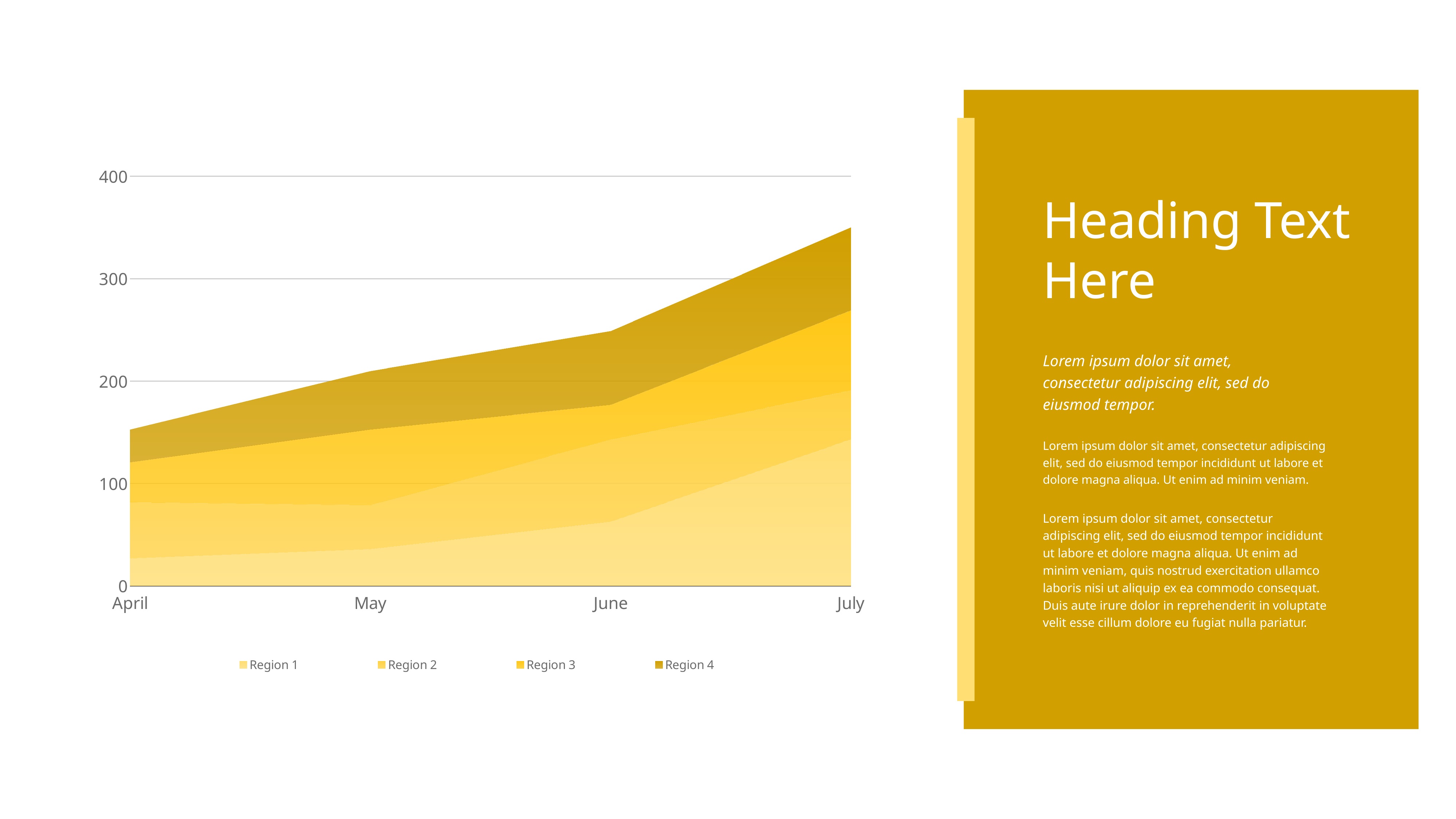
Is the stacked total for June greater or less than 200? greater How many series does the legend list? 4 Is the stacked total larger in July or in April? July Is the stacked total for May greater or less than 300? less How many months are shown along the x axis? 4 Does the stacked total rise or fall from April to July? Rise Is the stacked total for April greater or less than 200? less Which month has the highest stacked total? July What kind of chart is shown on the slide? Stacked area chart Which series is listed last in the legend? Region 4 Which month has the lowest stacked total? April